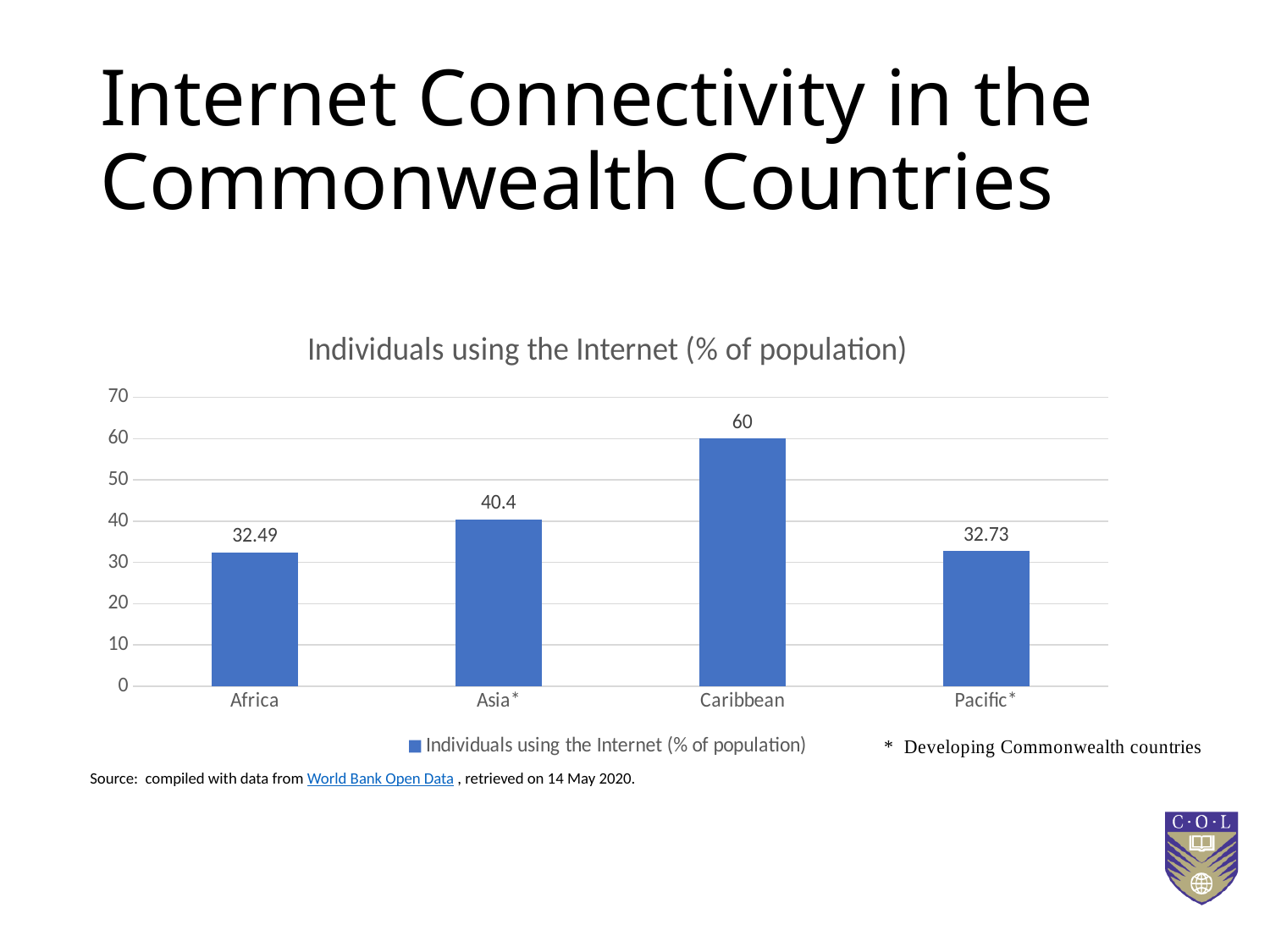
What is the title of the chart? Individuals using the Internet (% of population) What is the value for Pacific* in the chart? 32.73 Which region has the highest percentage of individuals using the Internet? Caribbean Which is larger, the value for Caribbean or the value for Asia*? Caribbean What type of chart is shown on the slide? bar chart What is the difference between the values for Caribbean and Asia*? 19.6 Is the value for Asia* greater or less than 50? less What is the value for Africa in the chart? 32.49 What is the value for Asia* in the chart? 40.4 What is the difference between the values for Asia* and Africa? 7.91 What is the value for Caribbean in the chart? 60 How many regions are shown in the chart? 4